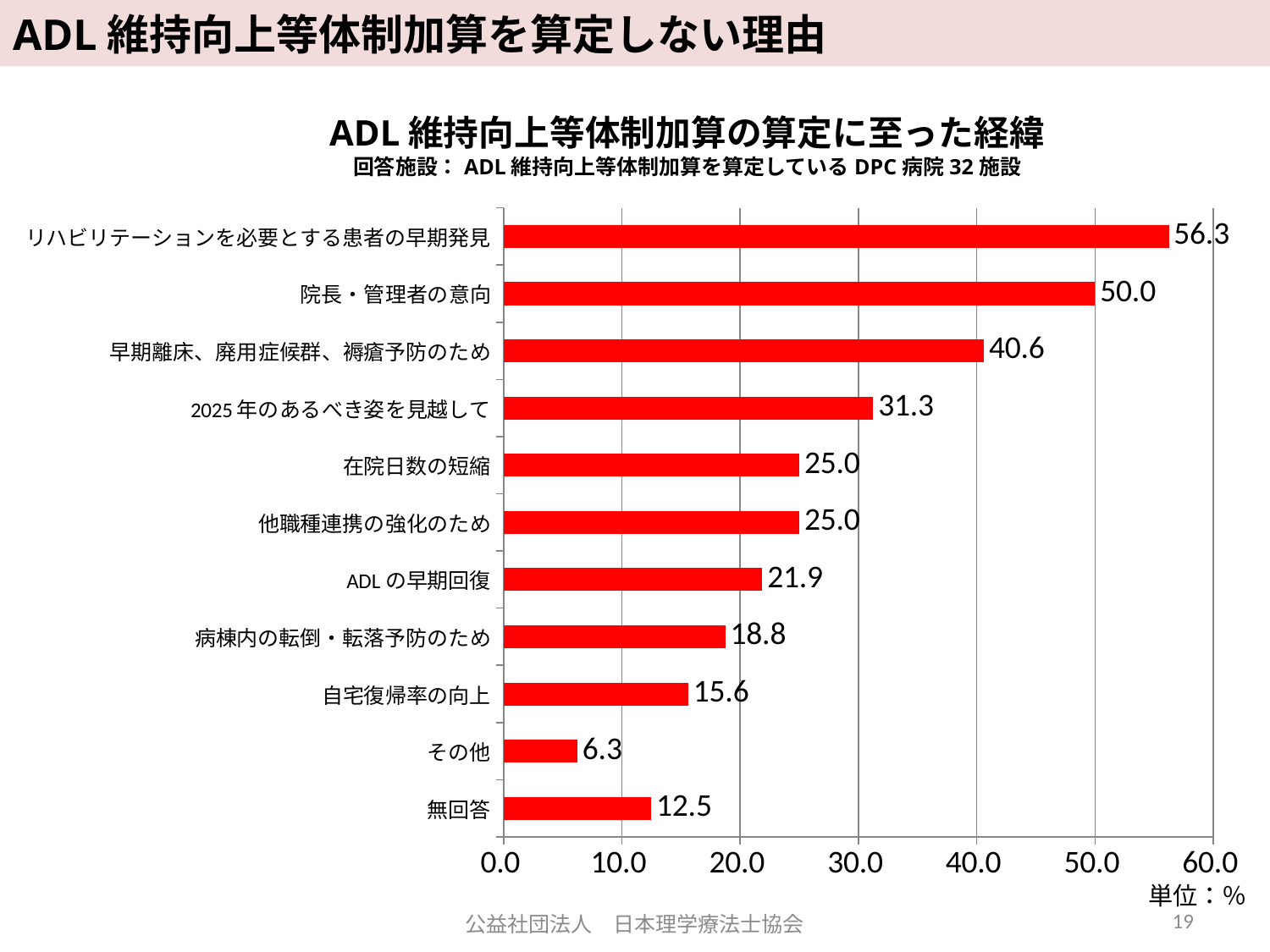
How many categories are shown in the chart? 11 What unit is indicated for the values in the chart? % What kind of chart is shown on the slide? bar chart What is the value for 無回答? 12.5 Which is larger, the value for ADLの早期回復 or the value for 自宅復帰率の向上? ADLの早期回復 Which category has the lowest value? その他 What is the title of the chart? ADL維持向上等体制加算の算定に至った経緯 What is the difference between the values for リハビリテーションを必要とする患者の早期発見 and 院長・管理者の意向? 6.3 What is the value for 2025年のあるべき姿を見越して? 31.3 Which category has the highest value? リハビリテーションを必要とする患者の早期発見 What is the value for 院長・管理者の意向? 50.0 Is the value for 早期離床、廃用症候群、褥瘡予防のため greater or less than 40.0? greater